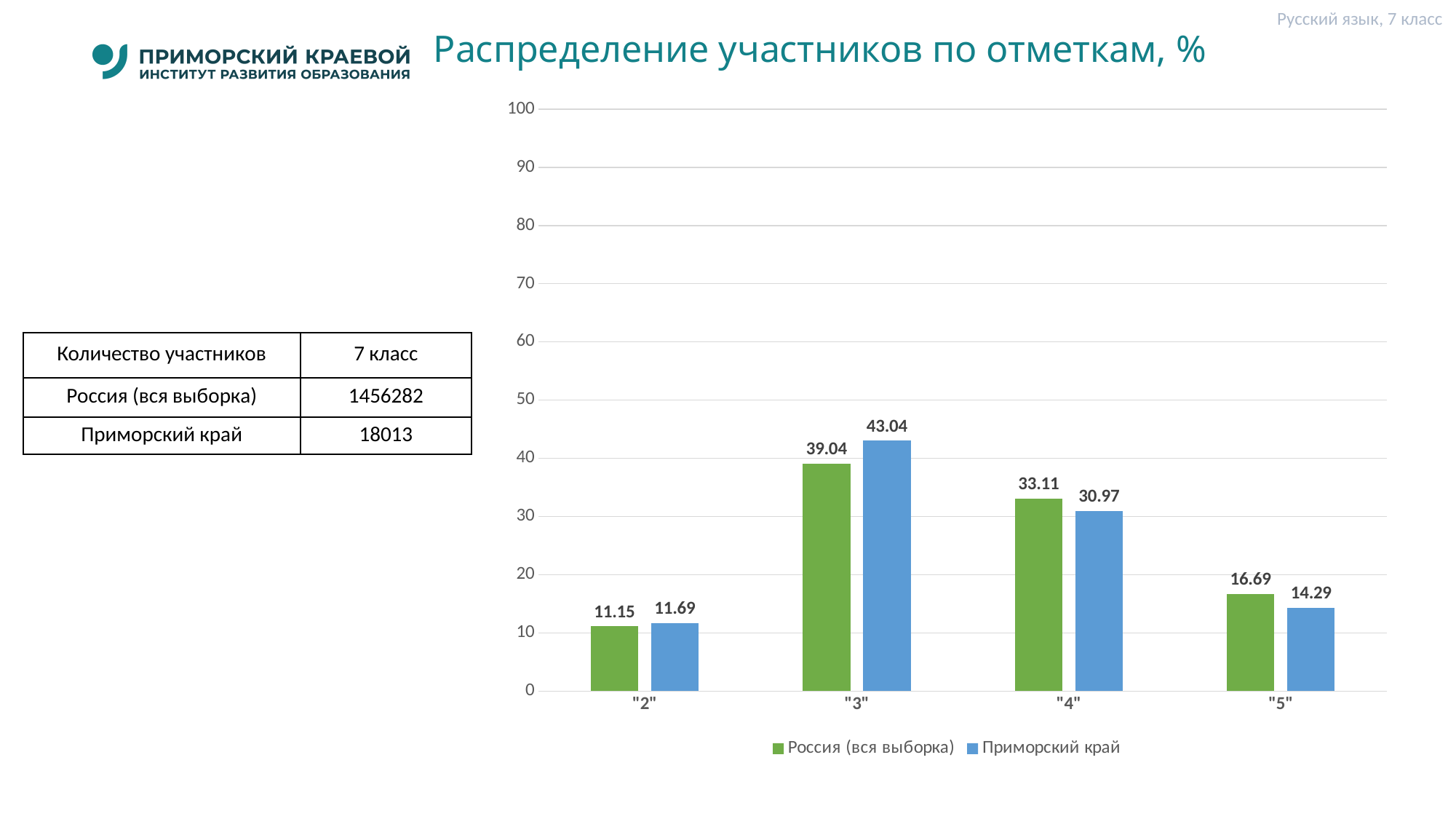
For grade "4", which series has the larger value: Россия (вся выборка) or Приморский край? Россия (вся выборка) How many series does the legend list? 2 What is the value for Приморский край for grade "2"? 11.69 Which grade has the lowest value for Россия (вся выборка)? "2" Which grade has the highest value for Приморский край? "3" What is the value for Россия (вся выборка) for grade "3"? 39.04 What is the difference between Приморский край and Россия (вся выборка) for grade "3"? 4.00 Is the value for Приморский край for grade "3" greater or less than 40? greater How many grade categories are shown on the x axis? 4 What is the value for Приморский край for grade "5"? 14.29 What kind of chart is shown on the slide? Bar chart What is the difference between Россия (вся выборка) and Приморский край for grade "4"? 2.14